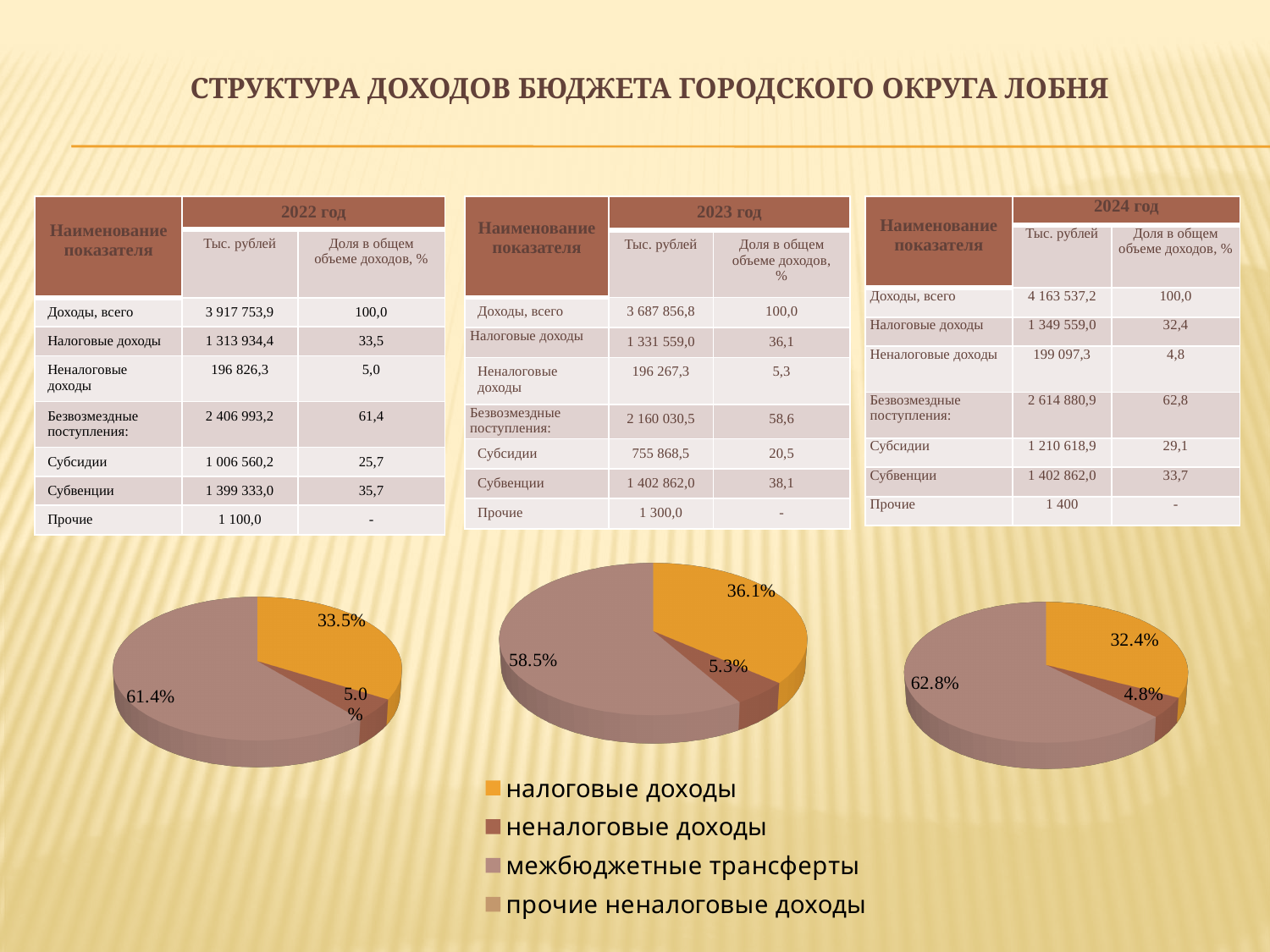
In the right pie chart, what is the difference between the labels for межбюджетные трансферты and налоговые доходы? 30.4% In the left pie chart, which legend category has the largest slice? межбюджетные трансферты In the middle pie chart, what is the difference between the labels for межбюджетные трансферты and налоговые доходы? 22.4% In the right pie chart, what is the data label on the orange slice (налоговые доходы)? 32.4% How many entries does the shared legend below the pie charts list? 4 What kind of chart is used on this slide? pie chart Which is larger: the налоговые доходы slice in the middle pie chart or in the right pie chart? middle pie chart In the middle pie chart, what is the data label on the largest slice (межбюджетные трансферты)? 58.5% In the left pie chart, what is the data label on the orange slice (налоговые доходы)? 33.5% How many pie charts are shown on the slide? 3 In the middle pie chart, which legend category has the smallest labelled slice? неналоговые доходы In the right pie chart, what is the data label on the slice for неналоговые доходы? 4.8%